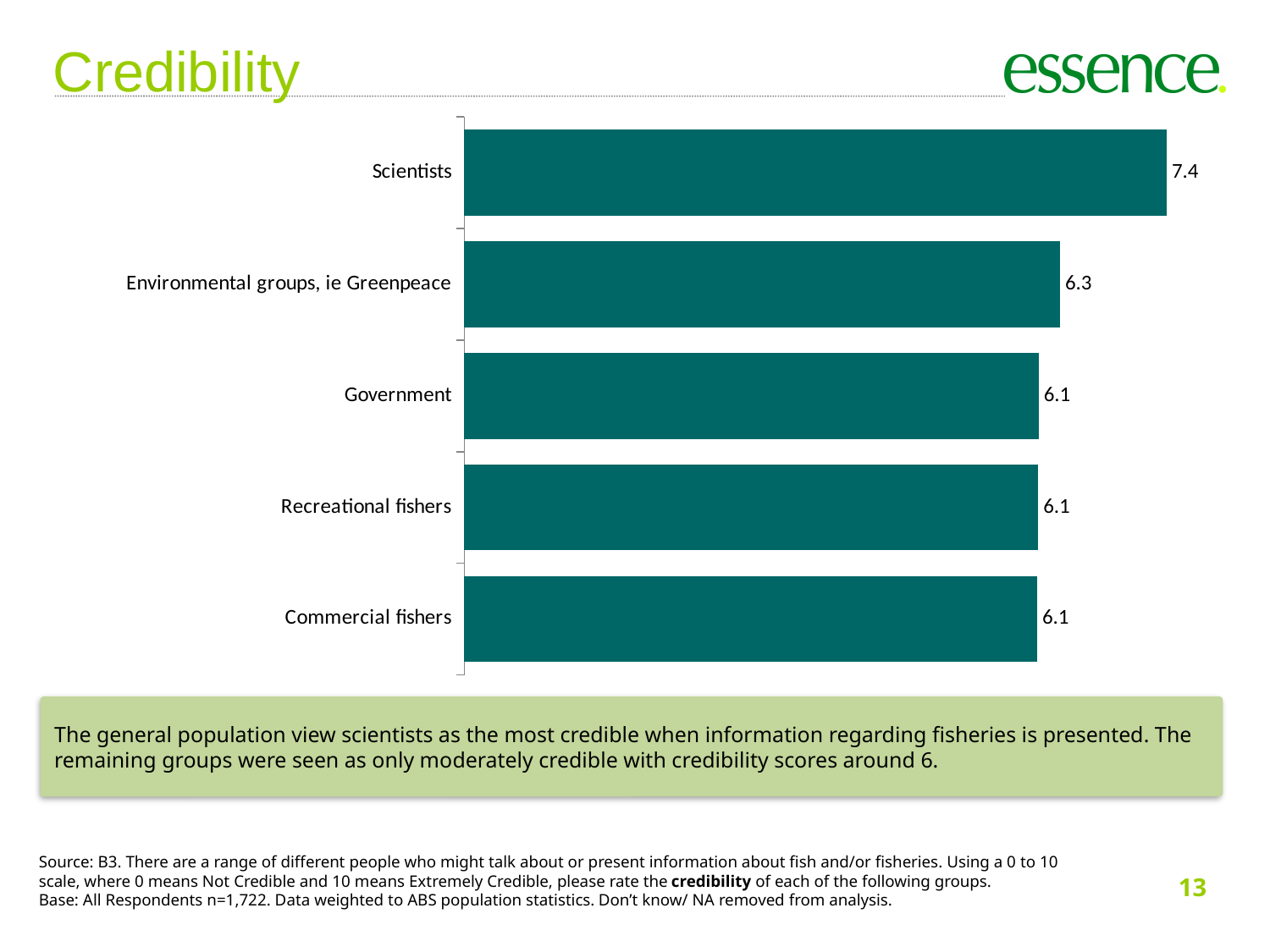
What is the difference between the credibility scores for Scientists and Government? 1.3 What is the difference between the credibility scores for Scientists and Environmental groups, ie Greenpeace? 1.1 What kind of chart is shown on the slide? Bar chart What is the credibility score for Environmental groups, ie Greenpeace? 6.3 What is the credibility score for Commercial fishers? 6.1 Which has a higher credibility score, Environmental groups, ie Greenpeace or Commercial fishers? Environmental groups, ie Greenpeace Which has a higher credibility score, Scientists or Recreational fishers? Scientists What is the credibility score for Scientists? 7.4 What is the credibility score for Government? 6.1 What is the title of the slide? Credibility How many groups are shown in the chart? 5 Which group has the highest credibility score? Scientists